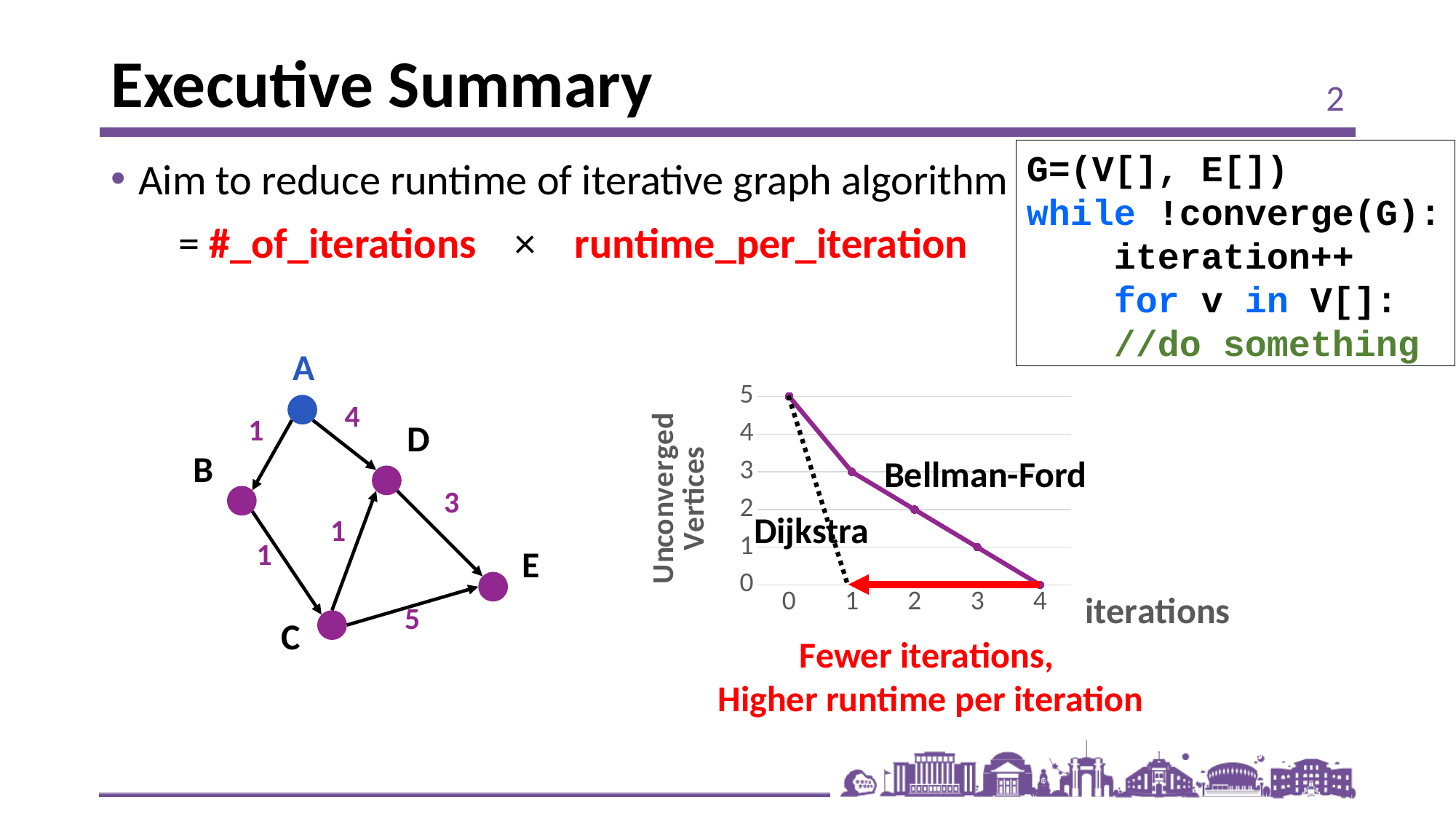
In the line chart, do the unconverged vertices for Bellman-Ford rise or fall as iterations increase? fall In the line chart, at which iteration does Dijkstra reach 0 unconverged vertices? 1 What is the label of the y axis of the line chart? Unconverged Vertices How many lines (algorithms) are plotted in the line chart? 2 In the line chart, how many unconverged vertices does Bellman-Ford have at iteration 0? 5 In the line chart, what is the difference in unconverged vertices for Bellman-Ford between iteration 0 and iteration 1? 2 In the line chart, at iteration 1, which has more unconverged vertices, Bellman-Ford or Dijkstra? Bellman-Ford What kind of chart is shown on the right side of the slide? line chart What is the label of the x axis of the line chart? iterations In the line chart, how many unconverged vertices does Bellman-Ford have at iteration 1? 3 In the line chart, how many unconverged vertices does Bellman-Ford have at iteration 2? 2 In the line chart, at which iteration does Bellman-Ford reach 0 unconverged vertices? 4